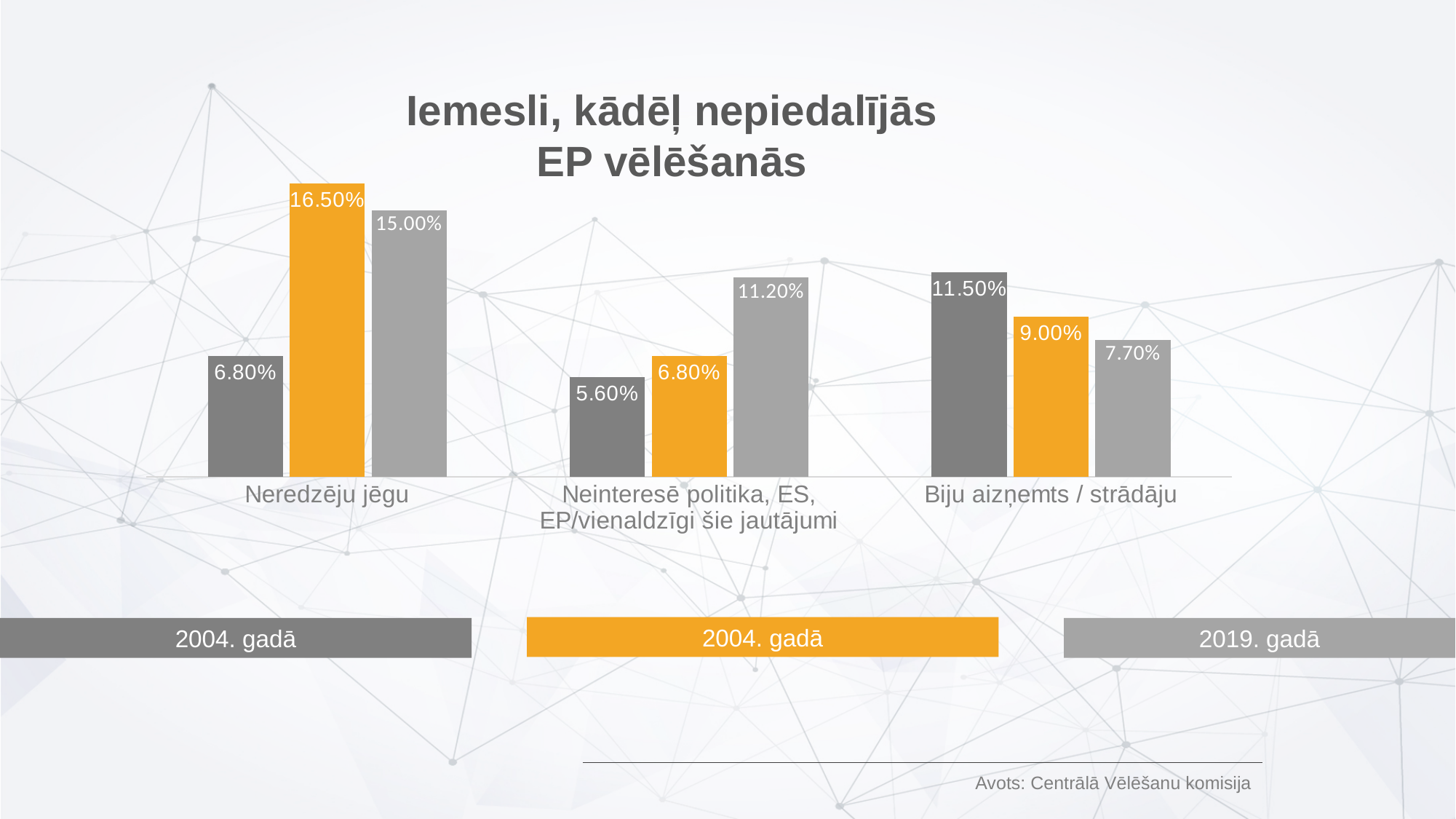
How many categories are shown on the x axis? 3 What is the difference between the orange bar and the light grey bar for "Neredzēju jēgu"? 1.50% Which category has the lowest dark grey bar? Neinteresē politika, ES, EP/vienaldzīgi šie jautājumi What is the value of the dark grey bar for "Biju aizņemts / strādāju"? 11.50% What is the difference between the dark grey bar and the light grey bar for "Biju aizņemts / strādāju"? 3.80% What is the title of the chart? Iemesli, kādēļ nepiedalījās EP vēlēšanās What is the value of the orange bar for "Neredzēju jēgu"? 16.50% How many series does the legend list? 3 What is the value of the light grey (2019. gadā) bar for "Neinteresē politika, ES, EP/vienaldzīgi šie jautājumi"? 11.20% Which category has the highest orange bar? Neredzēju jēgu What kind of chart is shown on the slide? Bar chart For "Neinteresē politika, ES, EP/vienaldzīgi šie jautājumi", which is larger: the orange bar or the light grey bar? The light grey bar